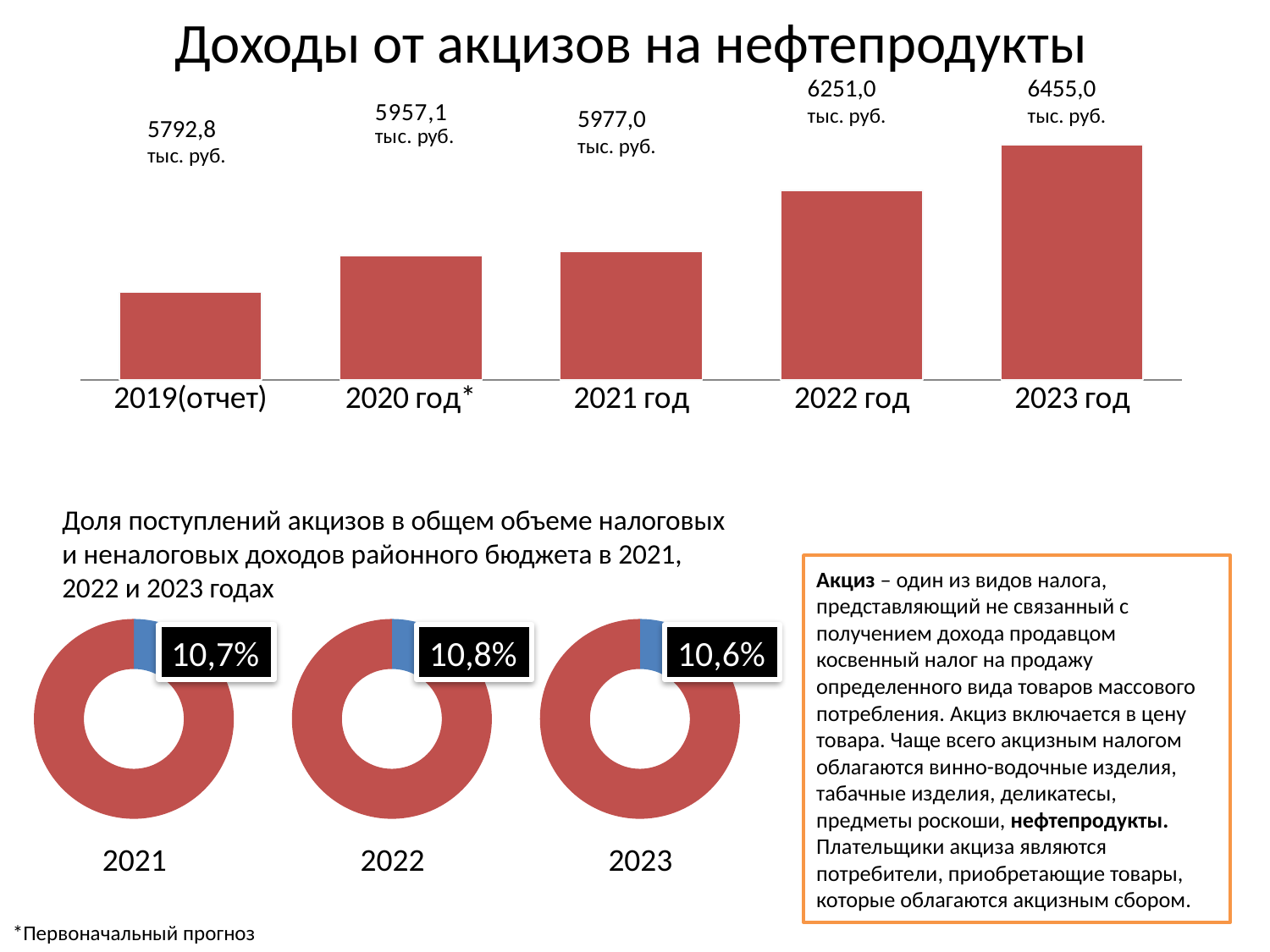
In the bar chart 'Доходы от акцизов на нефтепродукты', do the values rise or fall from 2019 to 2023? Rise What does the asterisk next to '2020 год*' in the bar chart refer to, according to the footnote? Первоначальный прогноз In the donut chart for 2022 at the bottom of the slide, what share is shown for the excise revenue? 10,8% In the bar chart 'Доходы от акцизов на нефтепродукты', which category has the lowest value? 2019(отчет) In the bar chart 'Доходы от акцизов на нефтепродукты', which year has the highest value? 2023 год In the bar chart 'Доходы от акцизов на нефтепродукты', which is larger: the value for 2022 год or for 2021 год? 2022 год In the bar chart 'Доходы от акцизов на нефтепродукты', what is the value for 2019(отчет)? 5792,8 тыс. руб. Among the three donut charts at the bottom of the slide, which year shows the lowest share? 2023 What kind of chart is the top chart 'Доходы от акцизов на нефтепродукты'? Bar chart In the bar chart 'Доходы от акцизов на нефтепродукты', what is the value for 2022 год? 6251,0 тыс. руб. In the bar chart 'Доходы от акцизов на нефтепродукты', what is the difference between the values for 2023 год and 2019(отчет)? 662,2 тыс. руб. How many bars are in the bar chart 'Доходы от акцизов на нефтепродукты'? 5